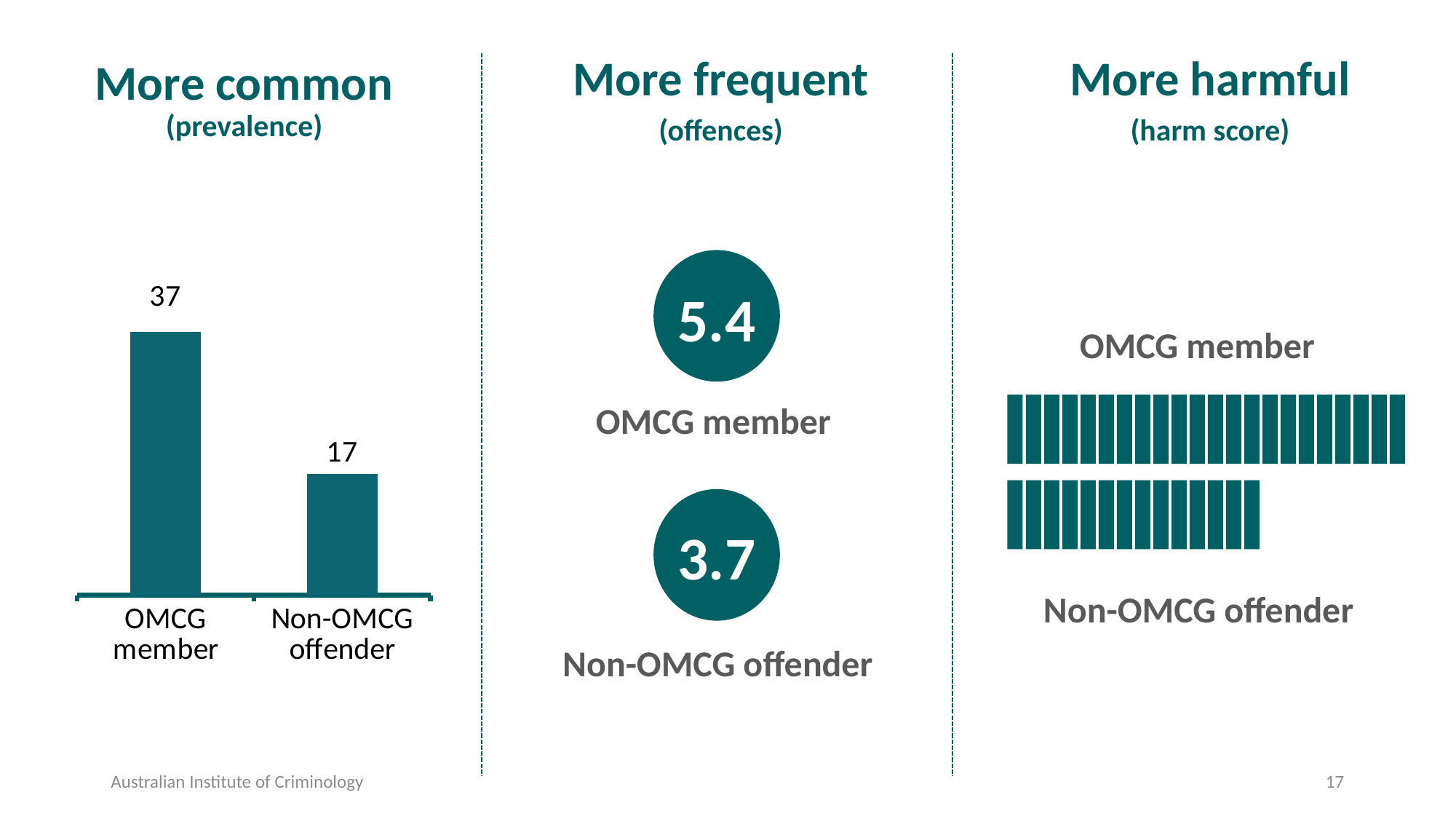
In the 'More frequent (offences)' panel, which group has the larger value: OMCG member or Non-OMCG offender? OMCG member In the 'More common (prevalence)' chart, which is larger: the value for OMCG member or for Non-OMCG offender? OMCG member In the 'More common (prevalence)' chart, what is the difference between the OMCG member value and the Non-OMCG offender value? 20 In the 'More frequent (offences)' panel, what is the value shown for Non-OMCG offender? 3.7 What is the subtitle in parentheses under the 'More common' heading on the left chart? (prevalence) In the 'More common (prevalence)' chart, which category has the lowest value? Non-OMCG offender In the 'More frequent (offences)' panel, what is the value shown for OMCG member? 5.4 In the 'More common (prevalence)' chart, what is the value for Non-OMCG offender? 17 How many categories are shown in the 'More common (prevalence)' chart? 2 In the 'More common (prevalence)' chart, which category has the highest value? OMCG member What kind of chart is the 'More common (prevalence)' chart? bar chart In the 'More common (prevalence)' chart, what is the value for OMCG member? 37